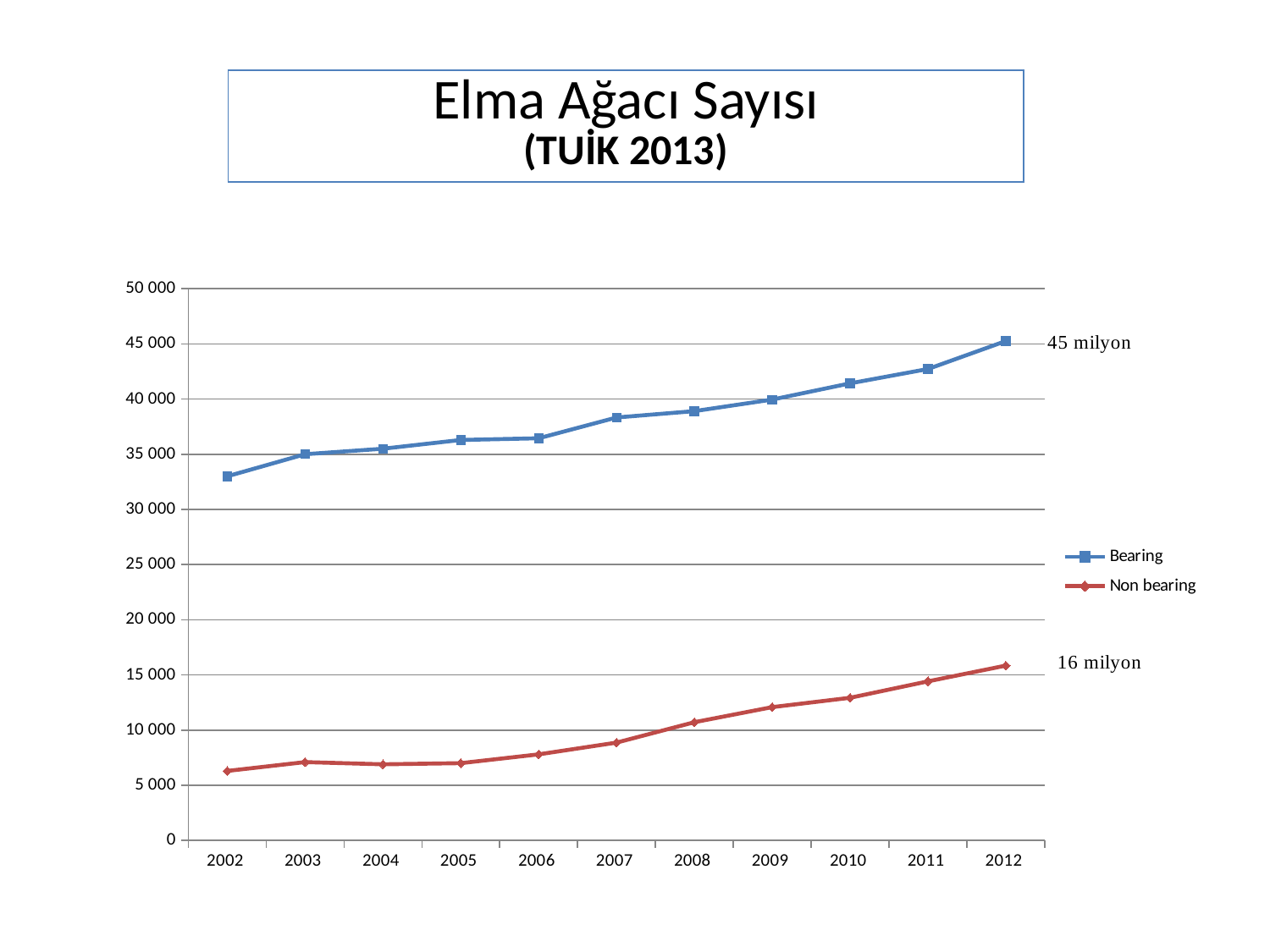
How many series does the legend list? 2 In which year is the Non bearing series at its lowest? 2002 In which year is the Bearing series at its highest? 2012 Is the value for Bearing in 2010 greater or less than 40 000? greater Is the value for Bearing in 2002 greater or less than 30 000? greater Which series has the larger value in 2012, Bearing or Non bearing? Bearing What kind of chart is shown on the slide? line chart Is the value for Non bearing in 2005 greater or less than 10 000? less Does the Bearing series rise or fall from 2002 to 2012? rise How many years are plotted along the x axis? 11 Does the Non bearing series rise or fall from 2005 to 2012? rise What is the title of the slide above the chart? Elma Ağacı Sayısı (TUİK 2013)